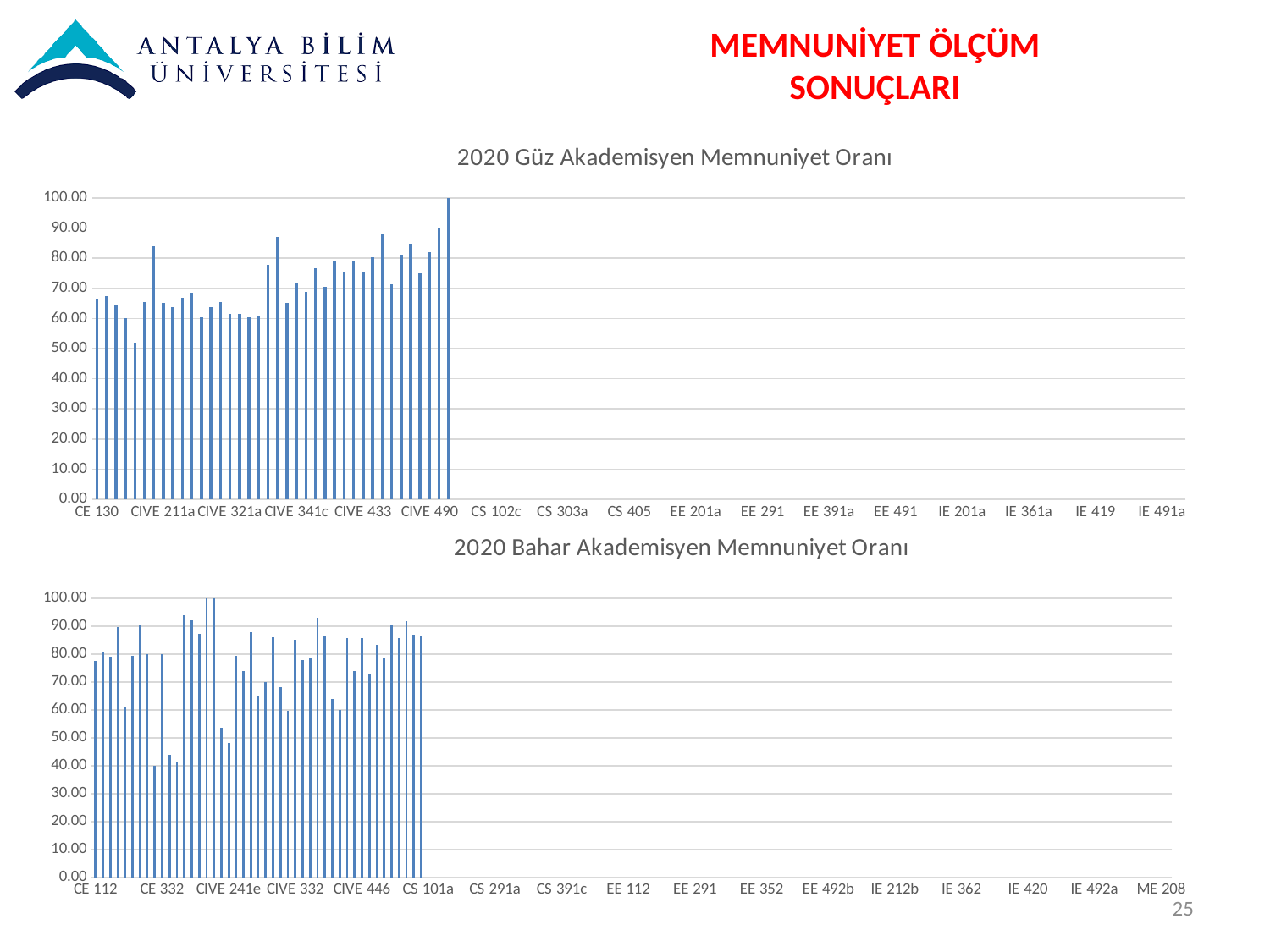
In the bottom chart, '2020 Bahar Akademisyen Memnuniyet Oranı', what is the highest value reached by any bar? 100.00 In the top chart, '2020 Güz Akademisyen Memnuniyet Oranı', is the value for CE 130 greater or less than 50? greater What is the title of the top chart on the slide? 2020 Güz Akademisyen Memnuniyet Oranı In the top chart, '2020 Güz Akademisyen Memnuniyet Oranı', is the lowest bar greater or less than 60? less In the bottom chart, '2020 Bahar Akademisyen Memnuniyet Oranı', is the lowest bar greater or less than 50? less What is the title of the bottom chart on the slide? 2020 Bahar Akademisyen Memnuniyet Oranı In the top chart, '2020 Güz Akademisyen Memnuniyet Oranı', what is the highest value reached by any bar? 100.00 What kind of chart is the top chart, '2020 Güz Akademisyen Memnuniyet Oranı'? bar chart What kind of chart is the bottom chart, '2020 Bahar Akademisyen Memnuniyet Oranı'? bar chart